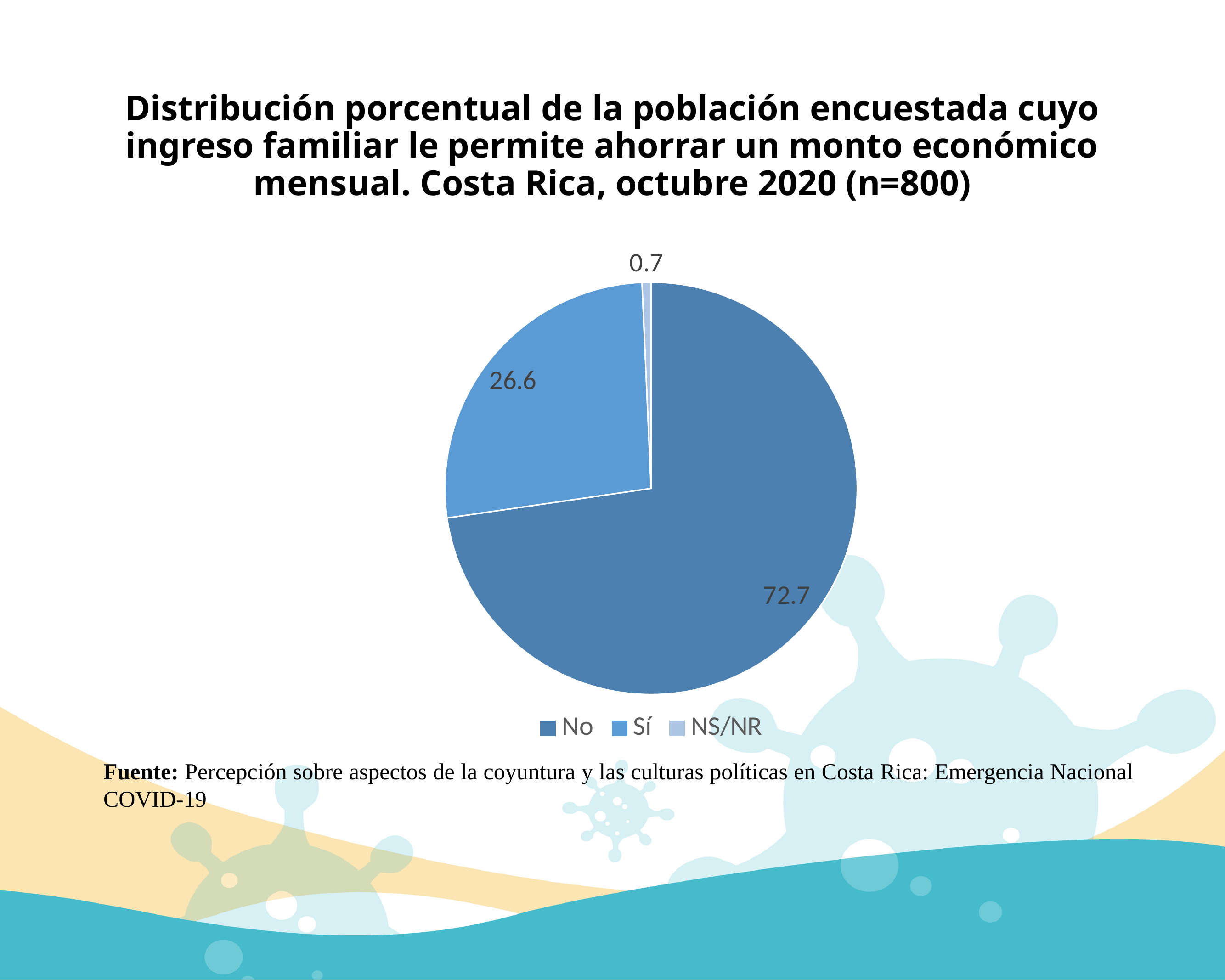
What kind of chart is shown on the slide? pie chart Which is larger, the "Sí" slice or the "NS/NR" slice? Sí Which category has the smallest slice? NS/NR Which category has the largest slice? No What is the value for the "No" slice? 72.7 What is the value for the "Sí" slice? 26.6 How many slices does the pie chart have? 3 How many entries does the legend list? 3 What is the difference between the "Sí" and "NS/NR" values? 25.9 What is the sample size (n) stated in the chart title? 800 What is the value for the "NS/NR" slice? 0.7 What is the difference between the "No" and "Sí" values? 46.1